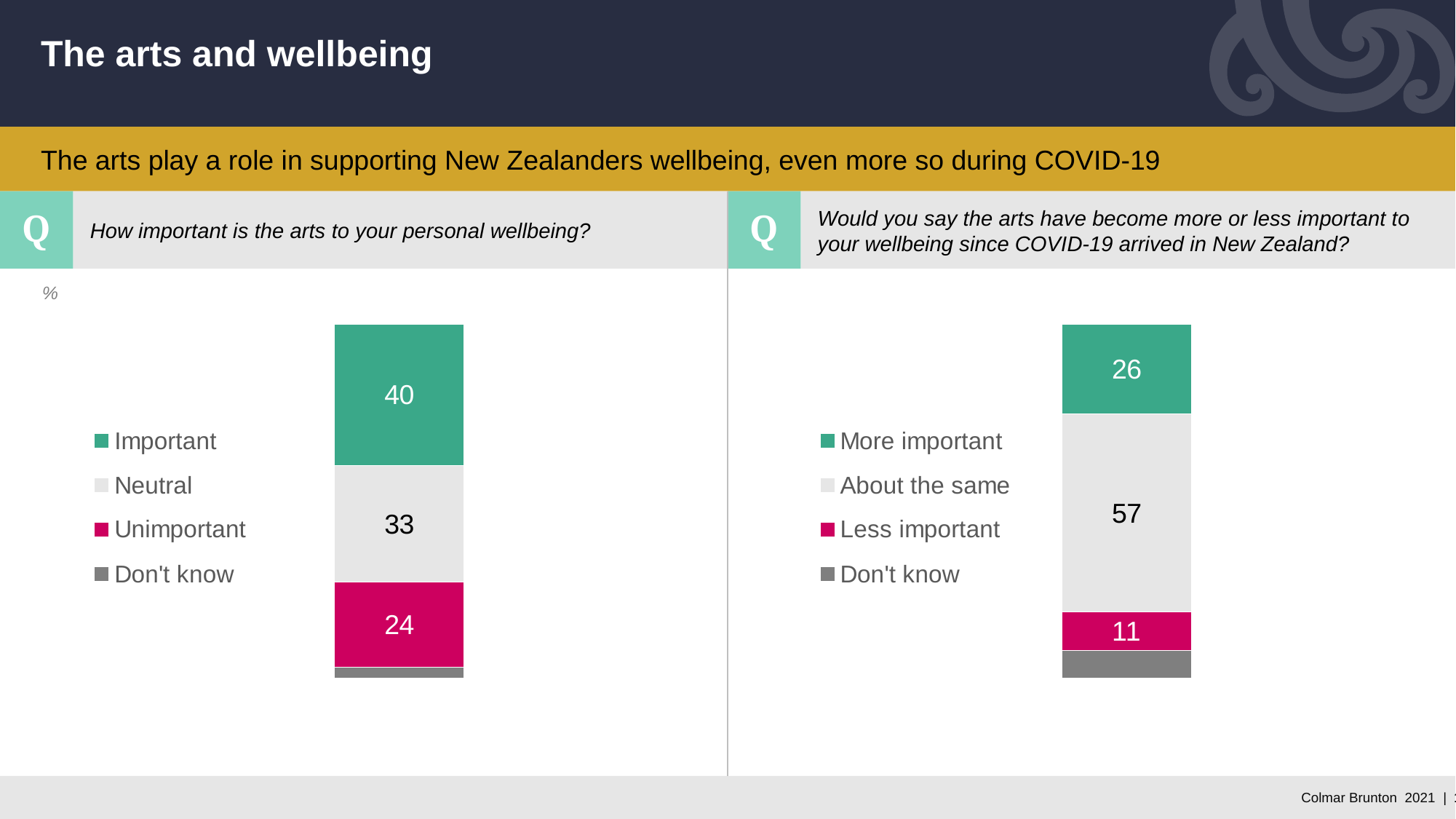
In the left chart (How important is the arts to your personal wellbeing?), what is the difference between the Important and Unimportant values? 16 In the left chart (How important is the arts to your personal wellbeing?), what is the value for Unimportant? 24 What type of chart is used in the right chart (Would you say the arts have become more or less important...)? Stacked bar chart In the right chart (Would you say the arts have become more or less important...), which labelled segment has the largest value? About the same In the left chart (How important is the arts to your personal wellbeing?), what is the value for Neutral? 33 In the right chart (Would you say the arts have become more or less important...), what is the value for About the same? 57 In the right chart (Would you say the arts have become more or less important...), which is larger: More important or Less important? More important In the left chart (How important is the arts to your personal wellbeing?), which labelled segment has the largest value? Important In the right chart (Would you say the arts have become more or less important...), what is the difference between More important and Less important? 15 In the left chart (How important is the arts to your personal wellbeing?), what percentage of respondents said the arts are Important? 40 In the right chart (Would you say the arts have become more or less important...), what is the value for Less important? 11 How many entries does the legend of the left chart (How important is the arts to your personal wellbeing?) list? 4